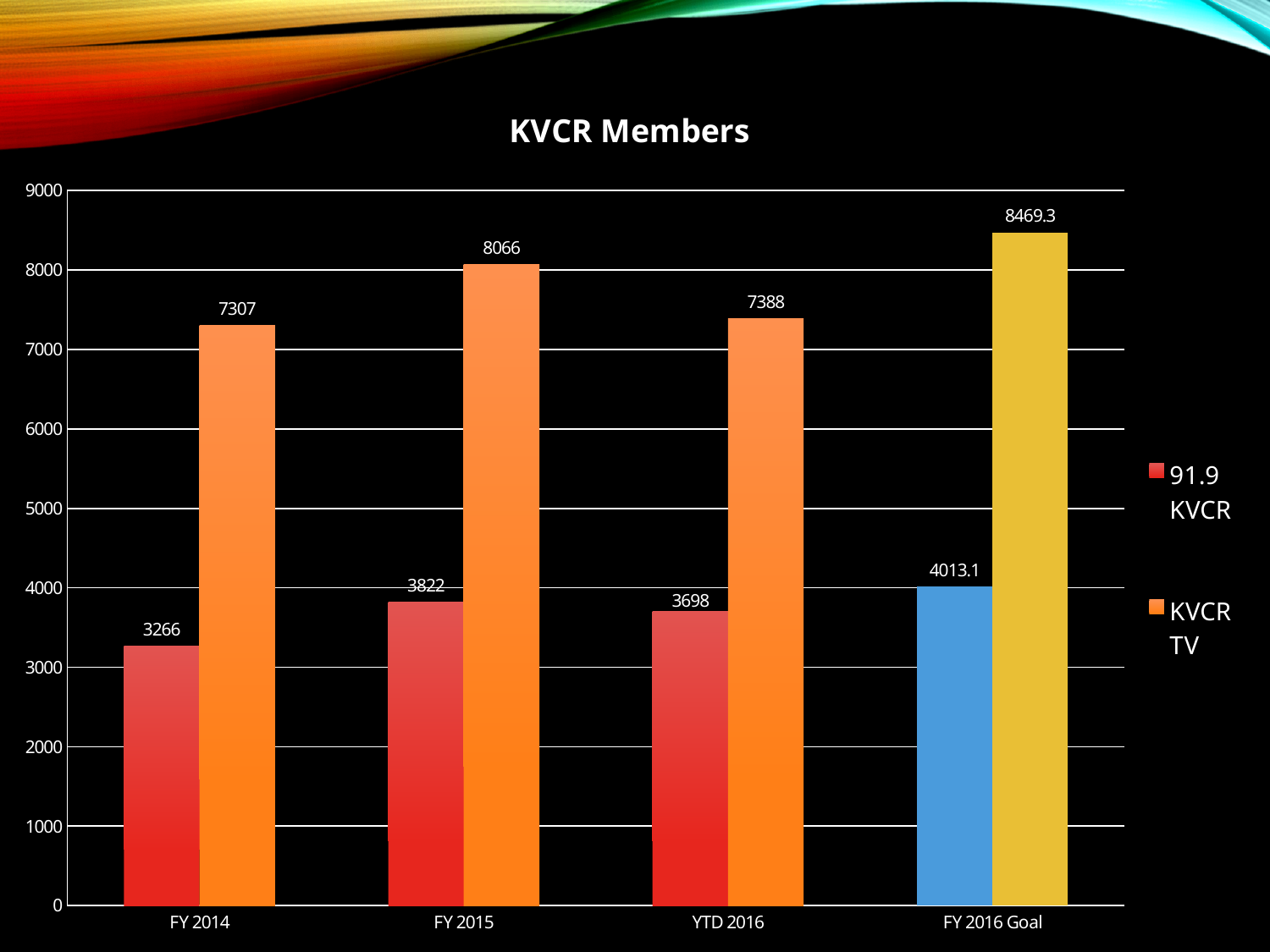
What is the value for 91.9 KVCR in FY 2014? 3266 How many categories are shown on the x axis? 4 What kind of chart is shown on the slide? Bar chart Which is larger, the KVCR TV value in FY 2014 or in YTD 2016? YTD 2016 Which category has the lowest 91.9 KVCR value? FY 2014 What is the title of the chart? KVCR Members How many series does the legend list? 2 What is the value for KVCR TV in FY 2015? 8066 What is the difference between the KVCR TV and 91.9 KVCR values in FY 2015? 4244 What is the value for KVCR TV in the FY 2016 Goal category? 8469.3 What is the value for 91.9 KVCR in YTD 2016? 3698 Which category has the highest KVCR TV value? FY 2016 Goal